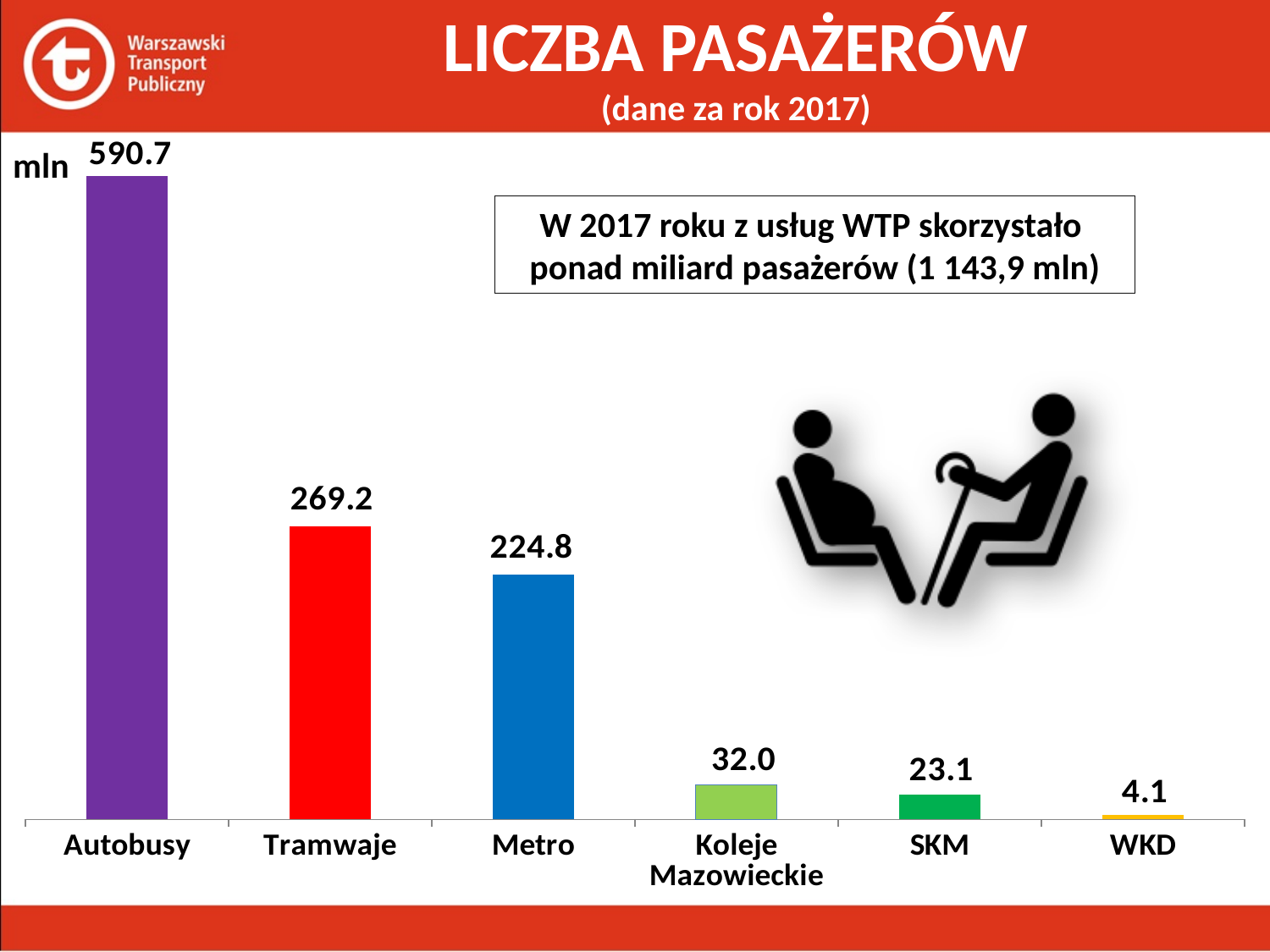
How many categories are shown on the chart? 6 What is the number of passengers (in mln) for Autobusy? 590.7 What is the difference in passengers (mln) between Koleje Mazowieckie and SKM? 8.9 What is the number of passengers (in mln) for WKD? 4.1 What is the number of passengers (in mln) for Metro? 224.8 What kind of chart is shown on the slide? Bar chart What is the title of the chart? LICZBA PASAŻERÓW (dane za rok 2017) What is the number of passengers (in mln) for Koleje Mazowieckie? 32.0 Which has more passengers, SKM or Koleje Mazowieckie? Koleje Mazowieckie What is the difference in passengers (mln) between Tramwaje and Metro? 44.4 Which category has the lowest number of passengers? WKD Which category has the highest number of passengers? Autobusy